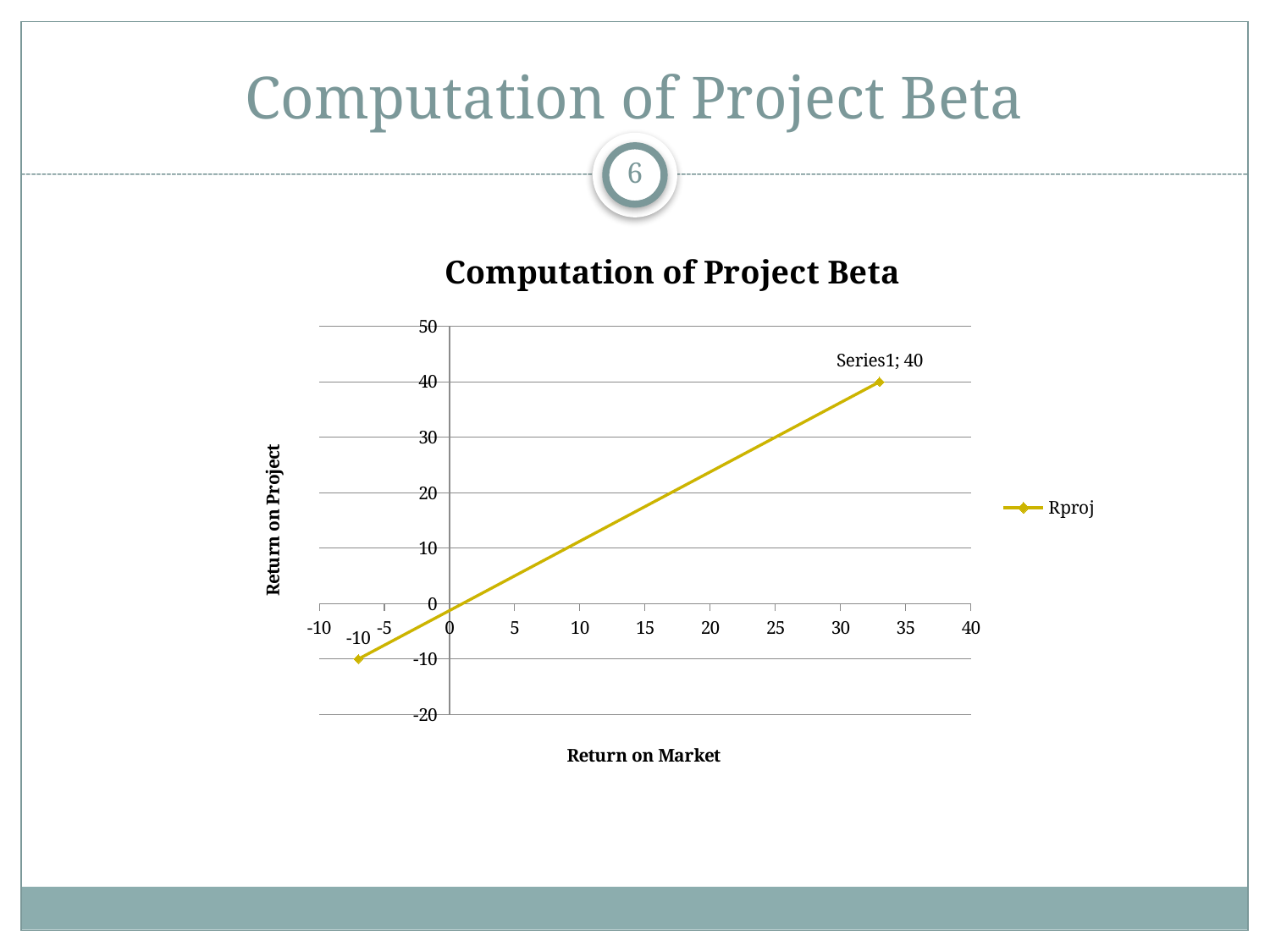
What is the lowest Return on Project value labelled on the chart? -10 What is the highest Return on Project value labelled on the chart? 40 What is the difference between the highest and lowest labelled Return on Project values? 50 Does the Return on Project rise or fall as Return on Market increases? rise Is the Return on Market for the data point labelled 'Series1; 40' greater or less than 30? greater What kind of chart is shown on the slide? line chart How many data points are plotted on the line? 2 Which data point has the larger Return on Project, the one at the left end of the line or the one at the right end? the right end What is the title of the chart? Computation of Project Beta How many series does the legend list? 1 Is the Return on Market for the data point labelled '-10' greater or less than -5? less What is the name of the series shown in the legend? Rproj